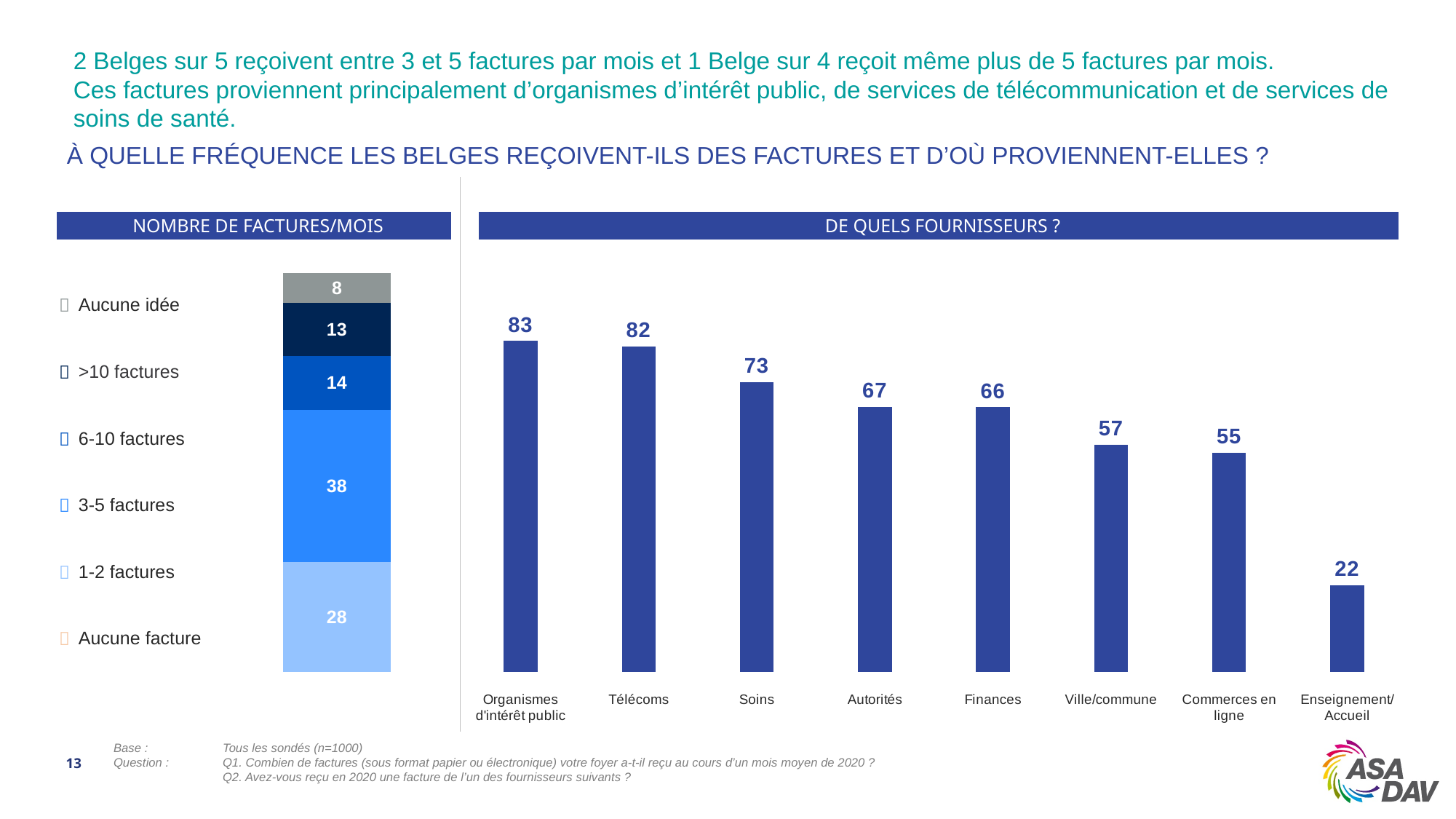
In the 'DE QUELS FOURNISSEURS ?' chart, which is larger, Finances or Commerces en ligne? Finances In the 'DE QUELS FOURNISSEURS ?' chart, what is the value for Ville/commune? 57 In the 'DE QUELS FOURNISSEURS ?' chart, do the values rise or fall from left to right? Fall In the 'DE QUELS FOURNISSEURS ?' chart, which category has the highest value? Organismes d'intérêt public In the 'DE QUELS FOURNISSEURS ?' chart, which category has the lowest value? Enseignement/Accueil In the 'DE QUELS FOURNISSEURS ?' chart, what is the value for Télécoms? 82 How many entries does the legend of the 'NOMBRE DE FACTURES/MOIS' chart list? 6 In the 'NOMBRE DE FACTURES/MOIS' chart, what is the value for 3-5 factures? 38 What kind of chart is 'DE QUELS FOURNISSEURS ?'? Bar chart In the 'NOMBRE DE FACTURES/MOIS' chart, what is the value for 1-2 factures? 28 In the 'DE QUELS FOURNISSEURS ?' chart, what is the difference between Soins and Autorités? 6 How many categories are shown in the 'DE QUELS FOURNISSEURS ?' chart? 8